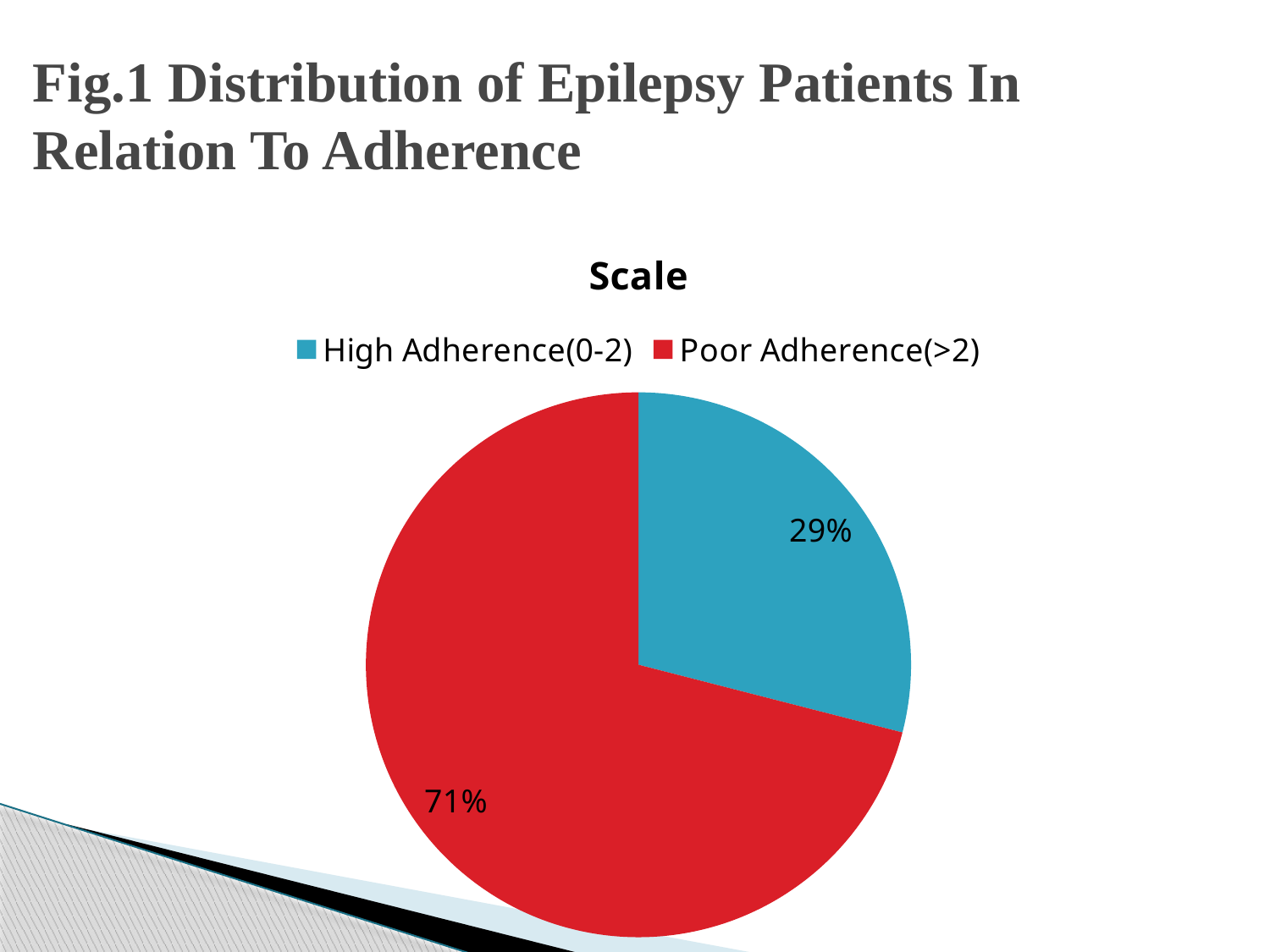
What is the chart's title? Scale What share of the pie is High Adherence(0-2)? 29% How many entries does the legend list? 2 What colour is the Poor Adherence(>2) slice? red What is the difference in percentage points between Poor Adherence(>2) and High Adherence(0-2)? 42 Which category has the smallest slice of the pie? High Adherence(0-2) How many categories does the pie chart show? 2 Which is larger, the High Adherence(0-2) slice or the Poor Adherence(>2) slice? Poor Adherence(>2) Which category has the largest slice of the pie? Poor Adherence(>2) What kind of chart is shown on the slide? pie chart What share of the pie is Poor Adherence(>2)? 71%